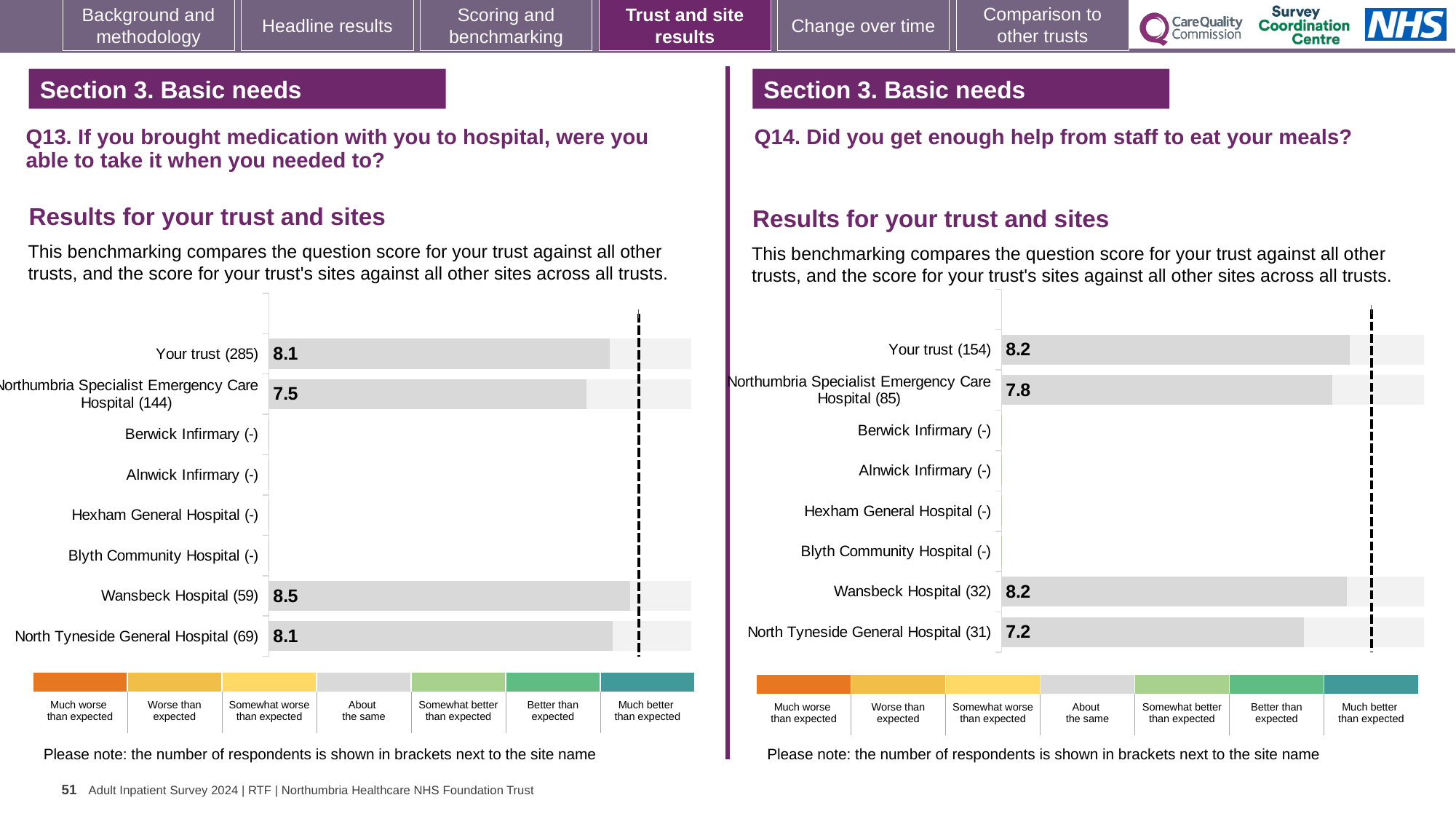
How many categories (trust and sites) are listed on the Q13 chart (left)? 8 On the Q13 chart (left), which site has the highest score? Wansbeck Hospital On the Q14 chart (right), what is the score for Northumbria Specialist Emergency Care Hospital? 7.8 On the Q13 chart (left), what is the difference between the scores for Wansbeck Hospital and Northumbria Specialist Emergency Care Hospital? 1.0 On the Q14 chart (right), what is the score for North Tyneside General Hospital? 7.2 On the Q13 chart (left), what is the score for Wansbeck Hospital? 8.5 On the Q13 chart (left), what is the score for Your trust? 8.1 On the Q14 chart (right), which site has the lowest score? North Tyneside General Hospital What kind of chart is used on the Q14 chart (right)? Bar chart On the Q13 chart (left), what is the score for Northumbria Specialist Emergency Care Hospital? 7.5 On the Q14 chart (right), what is the difference between the scores for Your trust and North Tyneside General Hospital? 1.0 On the Q14 chart (right), which is larger, the score for Your trust or the score for North Tyneside General Hospital? Your trust